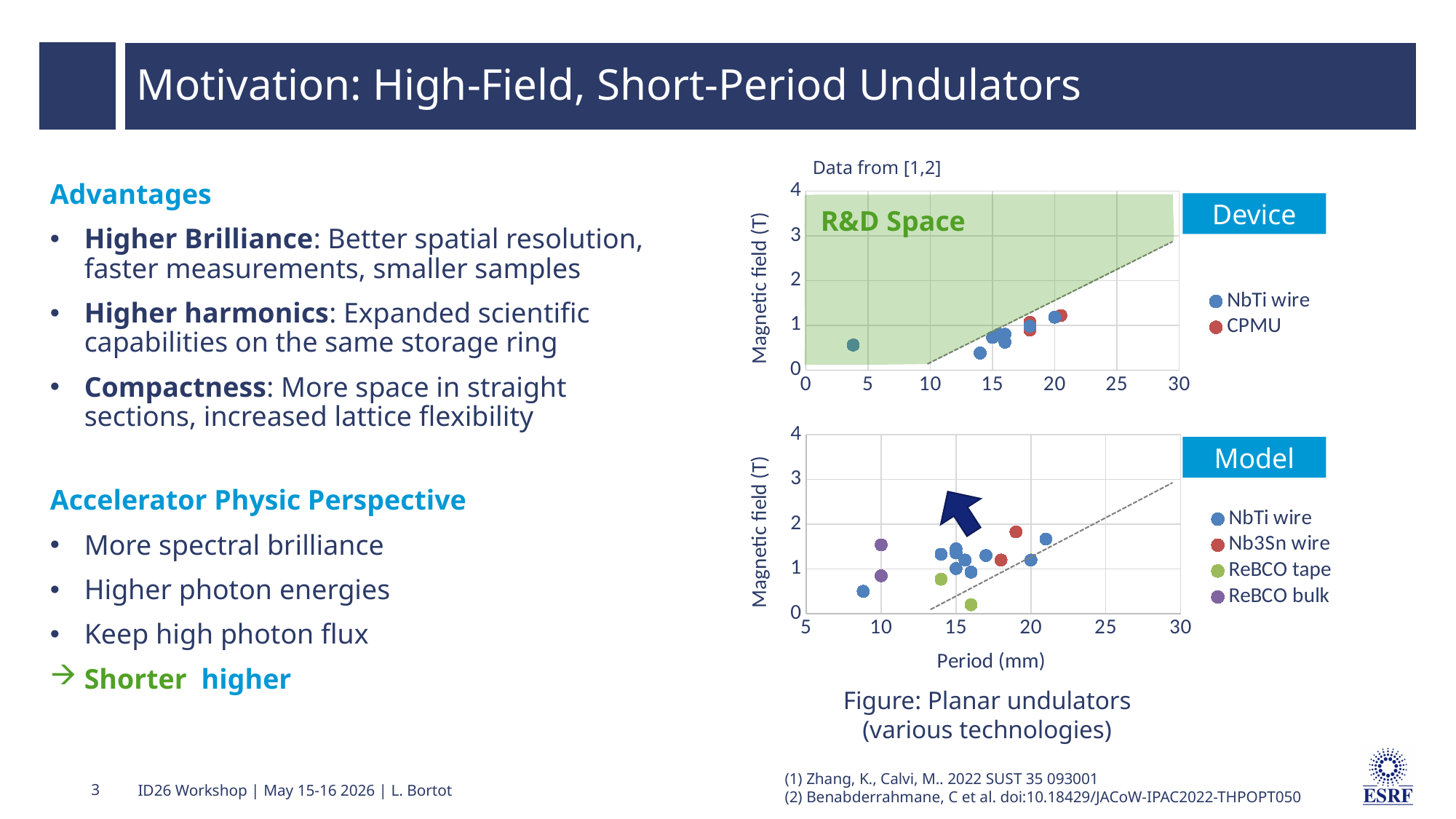
What is the x-axis label of the bottom "Model" chart? Period (mm) In the bottom "Model" chart, is the lowest ReBCO tape value greater or less than 1 T? less How many series does the legend of the bottom "Model" chart list? 4 In the bottom "Model" chart, what are the four series named in the legend? NbTi wire, Nb3Sn wire, ReBCO tape, ReBCO bulk In the bottom "Model" chart, is the highest Nb3Sn wire value greater or less than 1 T? greater In the top "Device" chart, is the highest CPMU value greater or less than 2 T? less In the top "Device" chart, do the NbTi wire values generally rise or fall as the period increases from 10 mm to 20 mm? rise What kind of chart is the top chart titled "Device"? scatter chart In the bottom "Model" chart, which series has the higher maximum magnetic field: ReBCO bulk or ReBCO tape? ReBCO bulk In the bottom "Model" chart, which series contains the lowest plotted magnetic field value? ReBCO tape How many series does the legend of the top "Device" chart list? 2